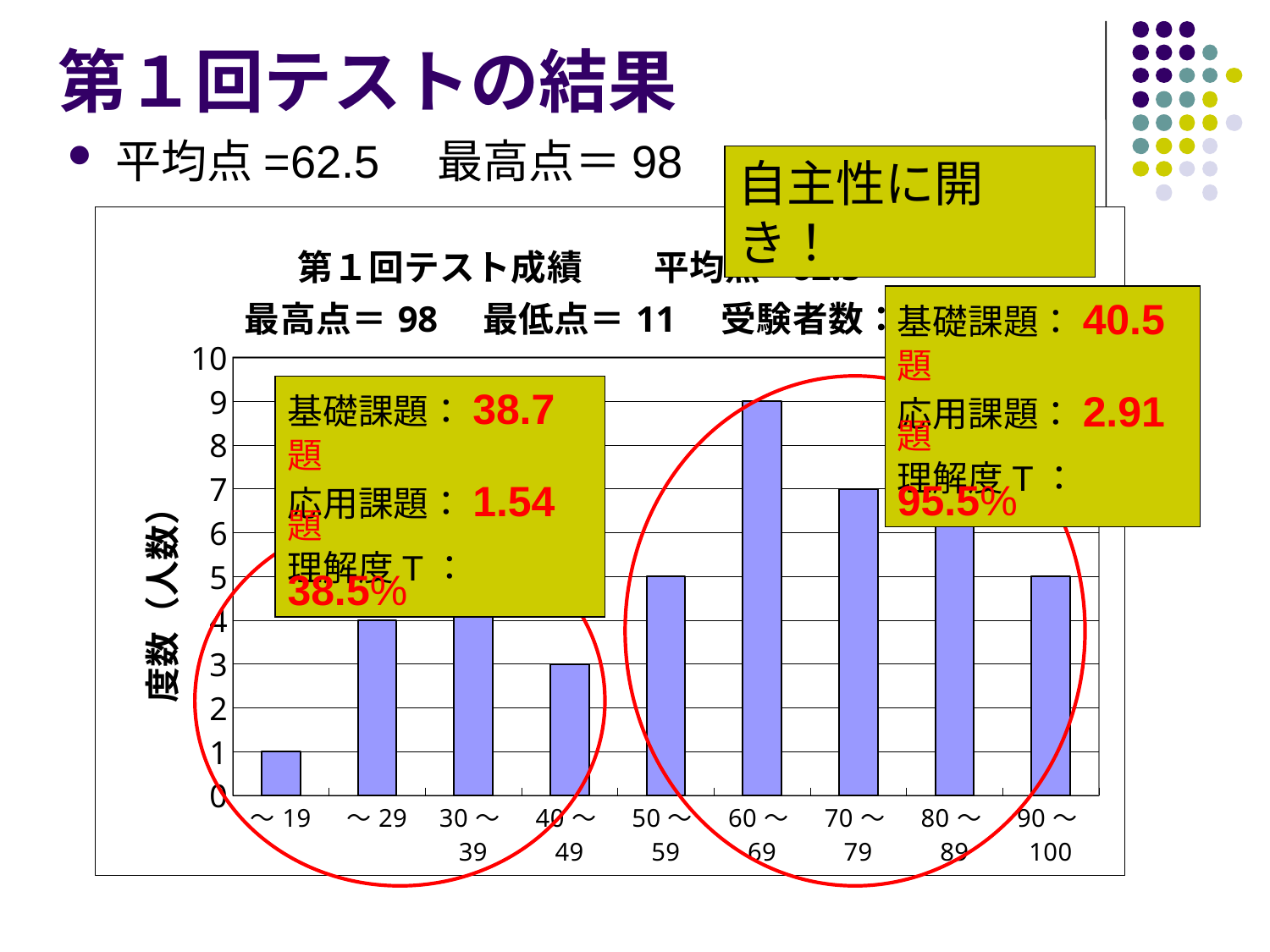
Which score range has a larger frequency, 70～79 or 90～100? 70～79 How many score-range categories are shown on the x axis of the chart? 9 What is the label of the vertical axis of the chart? 度数（人数） Which score range has the lowest frequency (度数) in the chart? ～19 What is the frequency (人数) for the 70～79 score range? 7 What kind of chart is shown on the slide? bar chart Is the frequency for the 80～89 score range greater or less than 5? greater What is the frequency (人数) for the 40～49 score range? 3 Which score range has the highest frequency (度数) in the chart? 60～69 What is the frequency (人数) for the ～19 score range? 1 What is the frequency (人数) for the 60～69 score range? 9 What is the difference in frequency between the 60～69 and 50～59 score ranges? 4